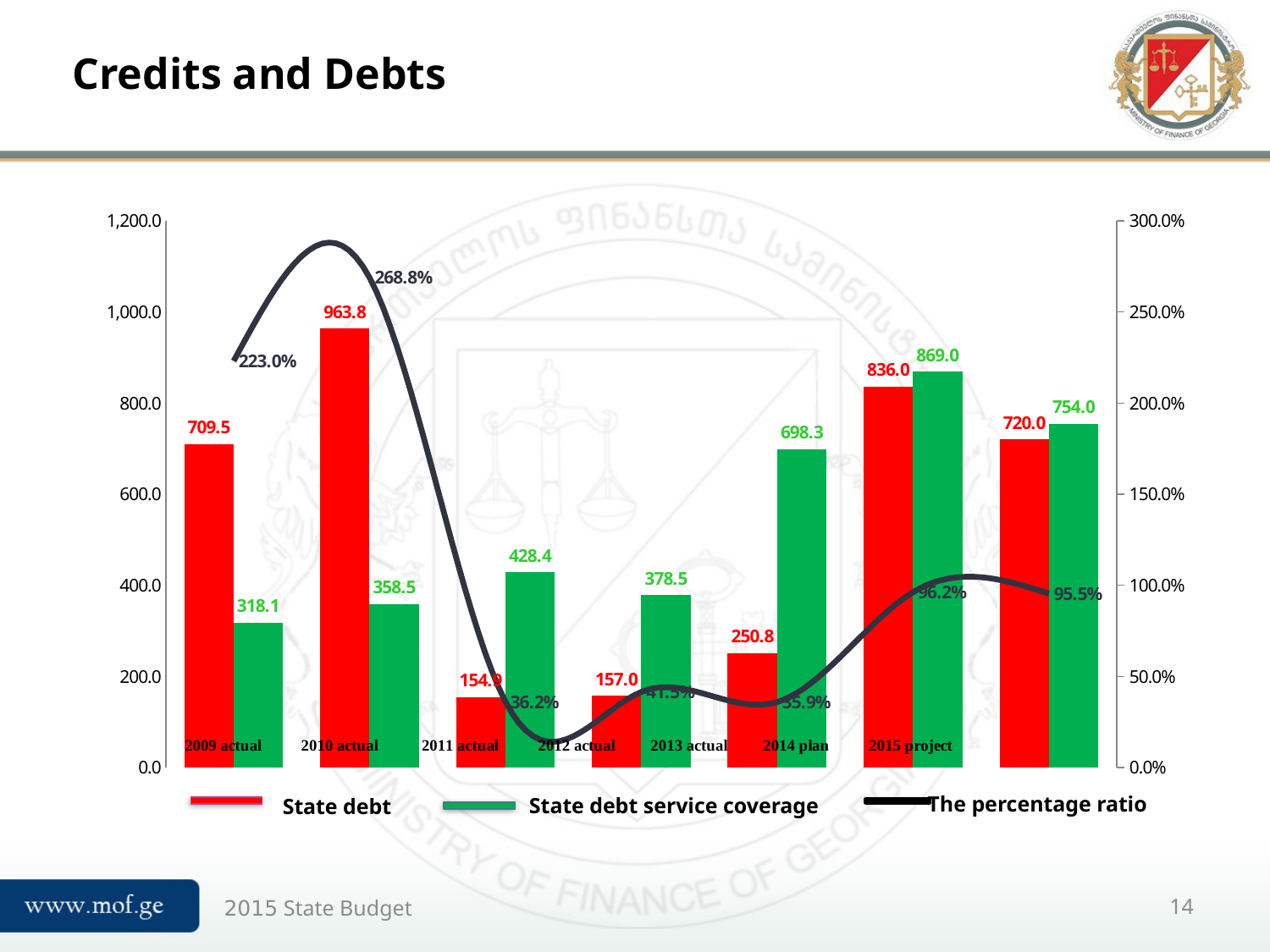
Which series is drawn as a black line? The percentage ratio Is the State debt value for 2010 actual greater or less than 800? greater What is the difference between the State debt values for 2010 actual and 2009 actual? 254.3 How many series does the legend list? 3 How many red State debt bars are plotted? 7 What kind of chart is shown on the slide? Combined bar and line chart What is the highest value labelled on the percentage ratio line? 268.8% Which is larger: the highest State debt bar or the highest State debt service coverage bar? State debt (963.8) What is the highest State debt value shown? 963.8 What is the lowest State debt service coverage value shown? 318.1 What is the State debt value for 2009 actual? 709.5 What is the State debt service coverage value for 2010 actual? 358.5